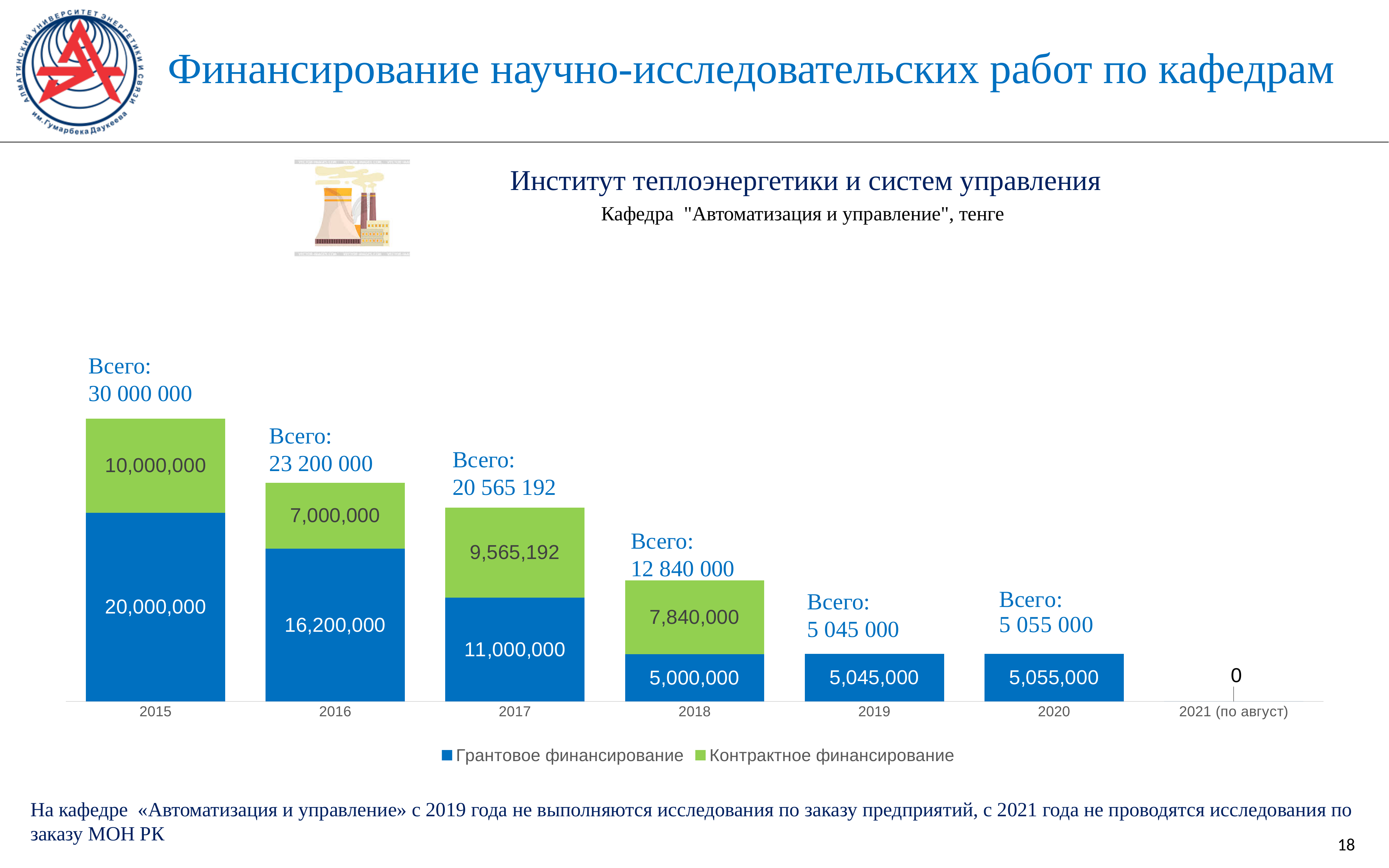
How many series does the legend list? 2 What is the value of Грантовое финансирование for 2020? 5,055,000 Which is larger: Контрактное финансирование in 2016 or in 2018? 2018 What is the difference between Грантовое финансирование in 2015 and in 2016? 3,800,000 How many years are shown on the x axis? 7 Which year has the lowest value of Грантовое финансирование? 2021 (по август) Do the total values rise or fall from 2015 to 2021? Fall What is the value of Грантовое финансирование for 2016? 16,200,000 What is the value of Контрактное финансирование for 2017? 9,565,192 What is the total funding (Всего) for 2017? 20 565 192 Which year has the highest value of Контрактное финансирование? 2015 What kind of chart is shown on the slide? Stacked bar chart